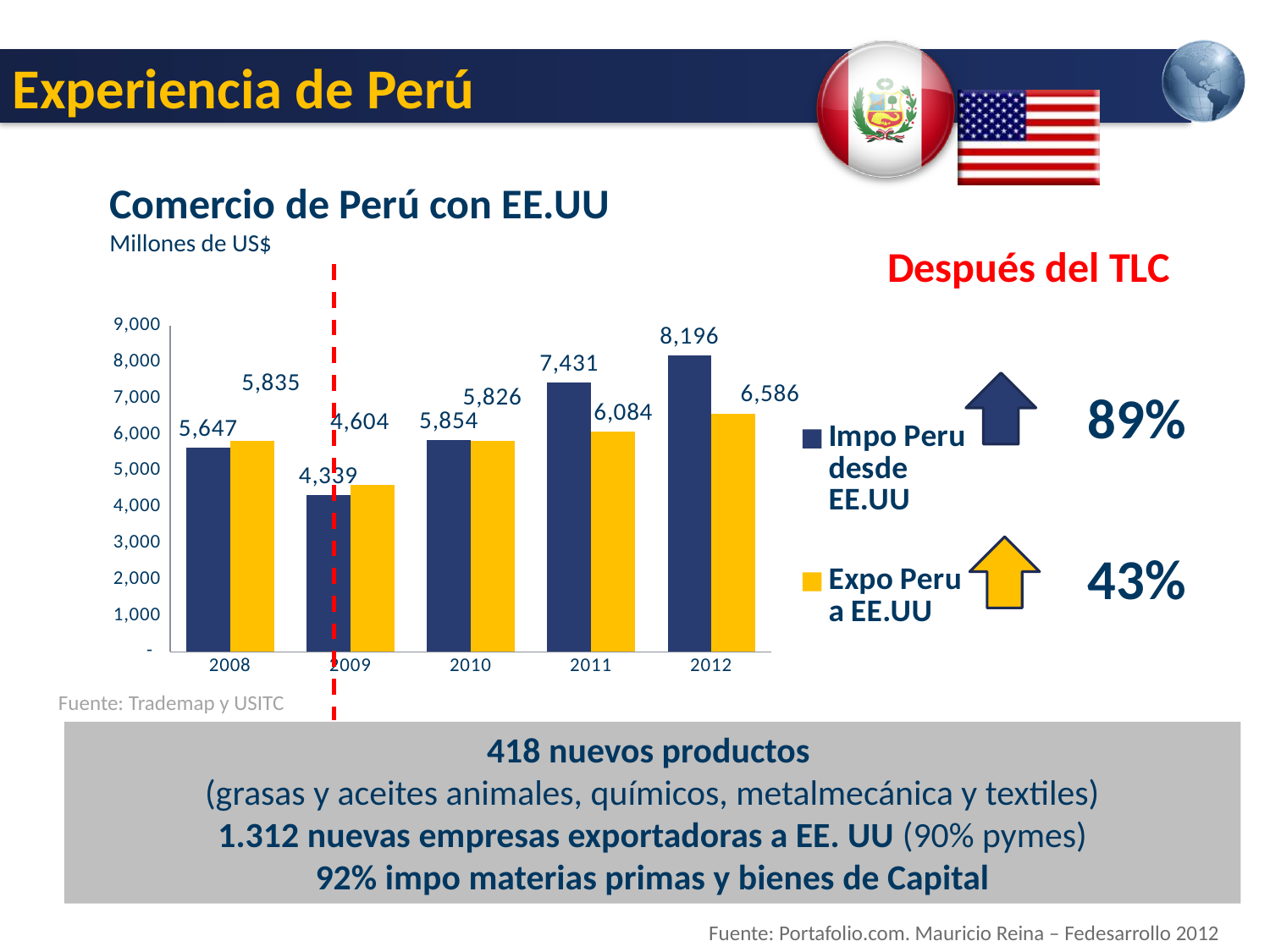
How many series does the legend list? 2 In which year is Impo Peru desde EE.UU highest? 2012 What is the difference between Impo Peru desde EE.UU and Expo Peru a EE.UU in 2012? 1,610 Which is larger in 2011: Impo Peru desde EE.UU or Expo Peru a EE.UU? Impo Peru desde EE.UU What is the value of Expo Peru a EE.UU in 2009? 4,604 What is the title of the chart? Comercio de Perú con EE.UU How many years are shown on the x axis of the chart? 5 What is the value of Impo Peru desde EE.UU in 2008? 5,647 What kind of chart is shown on the slide? Bar chart In which year is Expo Peru a EE.UU lowest? 2009 Is the value for Impo Peru desde EE.UU in 2011 greater or less than 7,000? greater What is the value of Impo Peru desde EE.UU in 2012? 8,196